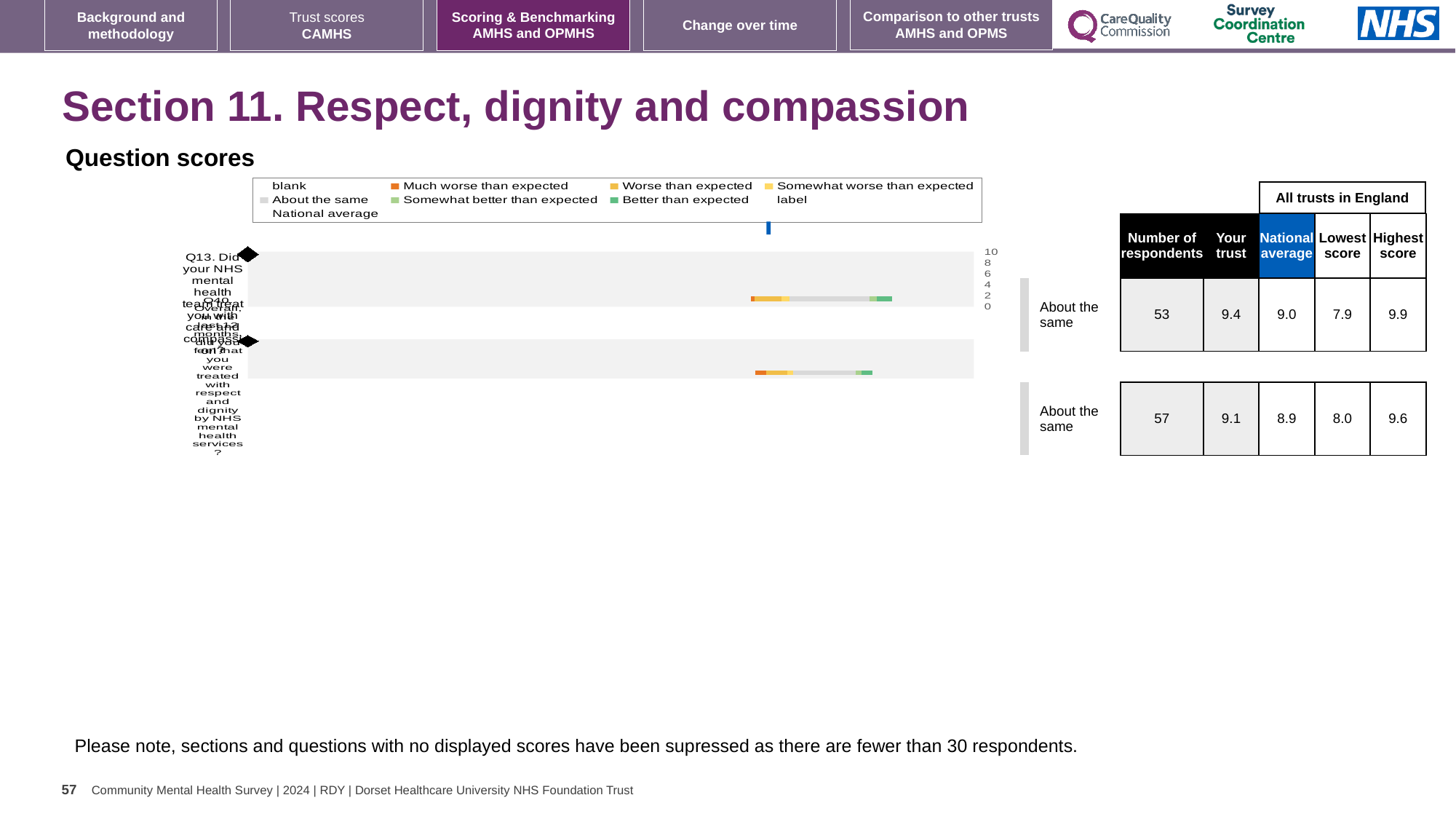
In the table beside the chart, what is the number of respondents for the top question row? 53 How many entries does the chart's legend list? 9 What benchmark category label is shown next to both question rows? About the same Which question row has more respondents, the top row or the bottom row? bottom row What is the maximum value shown on the chart's score axis? 10 In the table beside the chart, what is the 'Your trust' score for the top question row? 9.4 What kind of chart is shown under 'Question scores'? bar chart In the table beside the chart, what is the lowest score for the bottom question row? 8.0 What is the difference between the highest score and the lowest score for the top question row? 2.0 In the table beside the chart, what is the national average for the bottom question row? 8.9 Which question row has the higher 'Your trust' score, the top row or the bottom row? top row How many question rows (bars) are plotted in the chart? 2